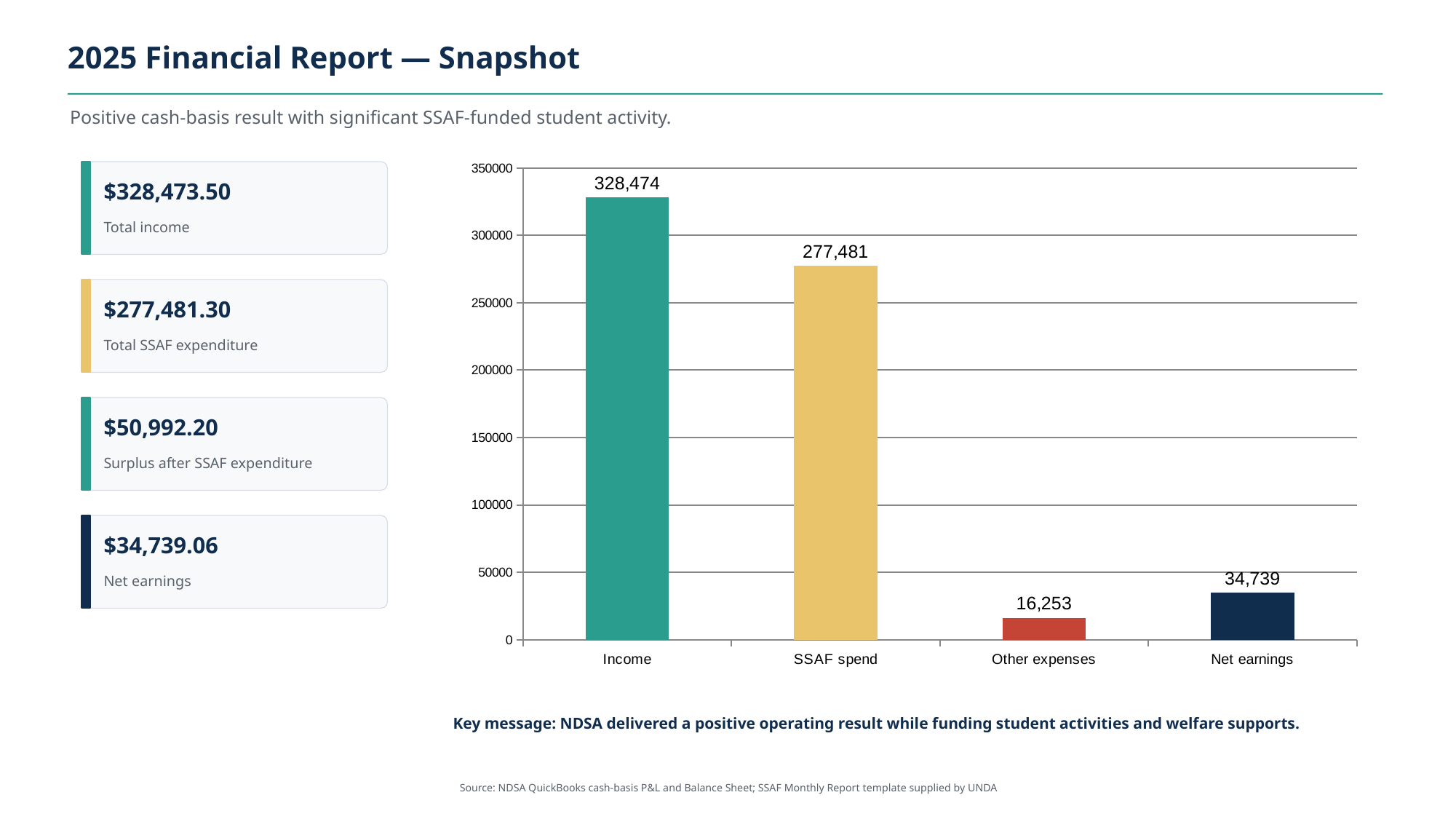
Which is larger, Net earnings or Other expenses? Net earnings What is the value of the Income bar? 328,474 What is the value of the SSAF spend bar? 277,481 Which category has the lowest value? Other expenses What kind of chart is shown on the slide? Bar chart How many categories are shown on the x axis? 4 Is the value for Net earnings greater or less than 50000? less What is the value of the Other expenses bar? 16,253 What is the difference between the Income and SSAF spend values? 50,993 What is the difference between the Net earnings and Other expenses values? 18,486 Which category has the highest value? Income What is the value of the Net earnings bar? 34,739